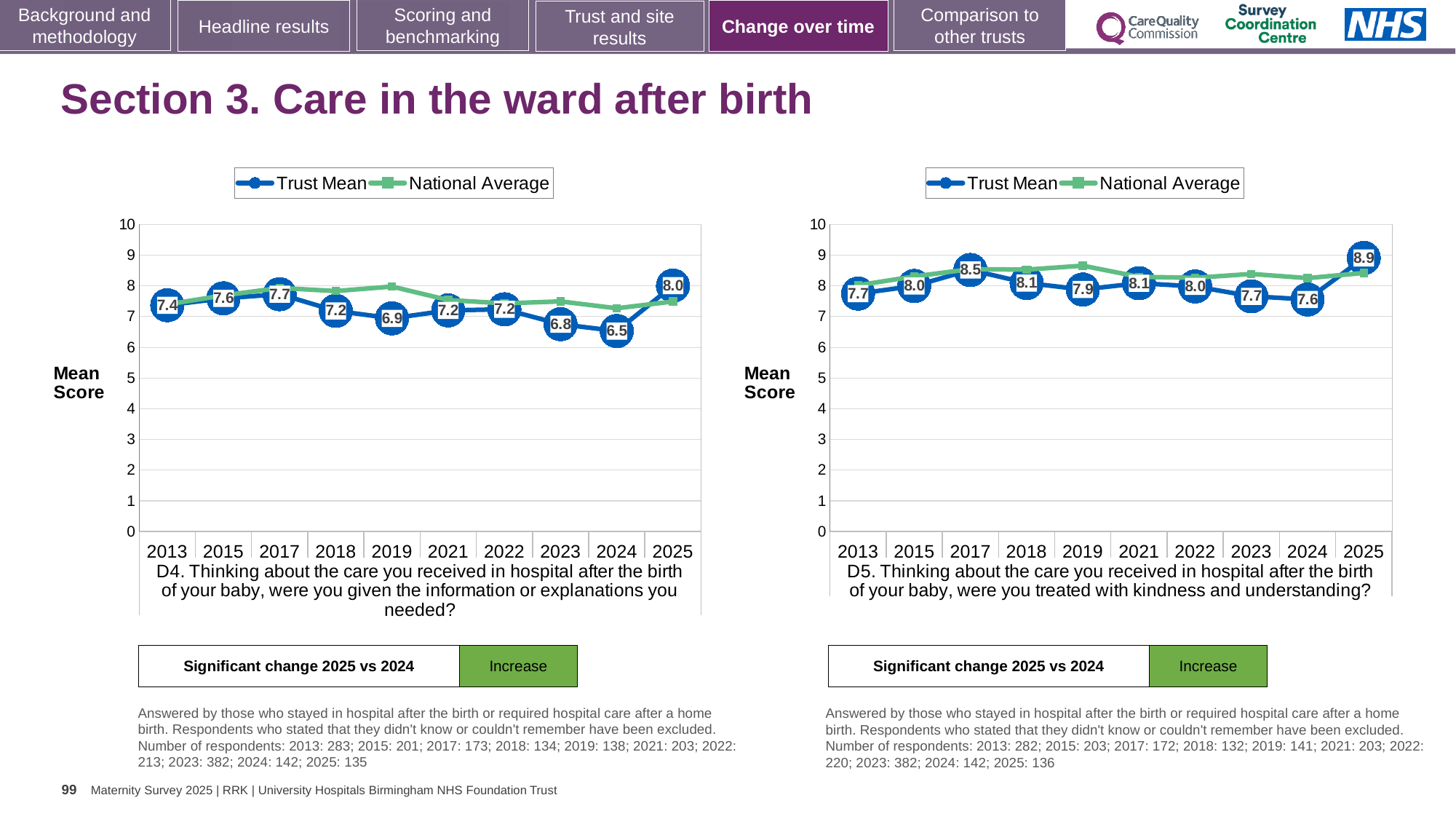
In the D5 chart (right), is the Trust Mean score for 2015 or 2023 larger? 2015 How many years are plotted on the x axis of the D4 chart (left)? 10 In the D4 chart (left), which year has the lowest Trust Mean score? 2024 How many series does the legend of the D5 chart (right) list? 2 In the D4 chart (left), what is the Trust Mean score for 2019? 6.9 What type of chart is the D4 chart (left)? Line chart In the D5 chart (right), is the National Average value for 2019 greater or less than 8? greater In the D4 chart (left), what is the difference between the Trust Mean scores for 2025 and 2024? 1.5 In the D5 chart (right), what is the Trust Mean score for 2017? 8.5 In the D5 chart (right), which year has the highest Trust Mean score? 2025 In the D4 chart (left), what is the Trust Mean score for 2025? 8.0 In the D5 chart (right), which year has the lowest Trust Mean score? 2024